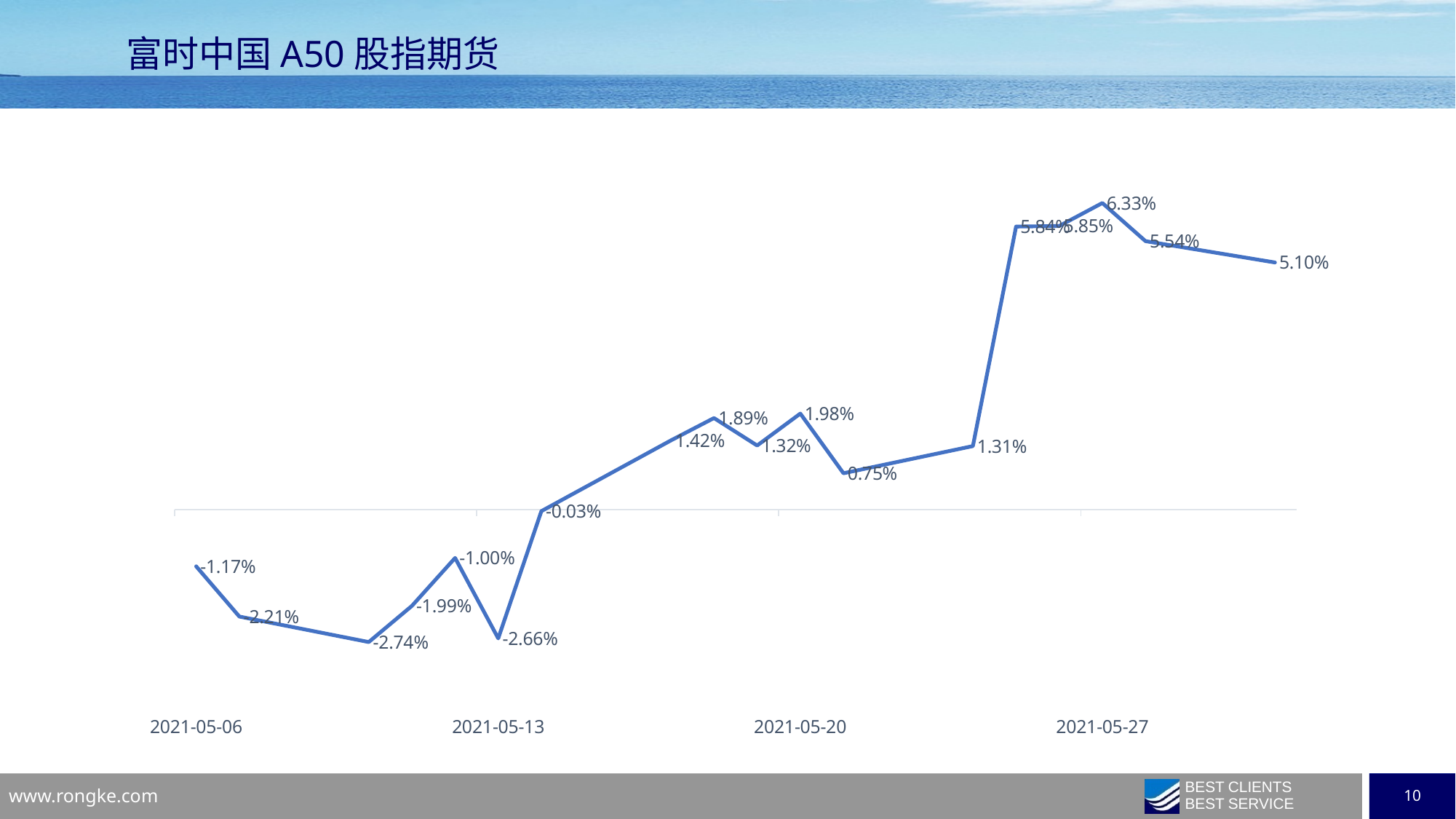
What is the value plotted at 2021-05-27? 6.33% What kind of chart is shown on the slide? Line chart What is the highest value shown on the chart? 6.33% What is the value of the last data point on the line? 5.10% Do the values generally rise or fall from left to right along the x axis? Rise What is the difference between the value at 2021-05-27 and the last data point (5.10%)? 1.23 percentage points How many data points are plotted on the line? 18 What is the value plotted at 2021-05-13? -2.66% What is the value plotted at 2021-05-06? -1.17% Which date has the larger value, 2021-05-20 or 2021-05-27? 2021-05-27 What is the lowest value shown on the chart? -2.74% What is the value plotted at 2021-05-20? 1.98%